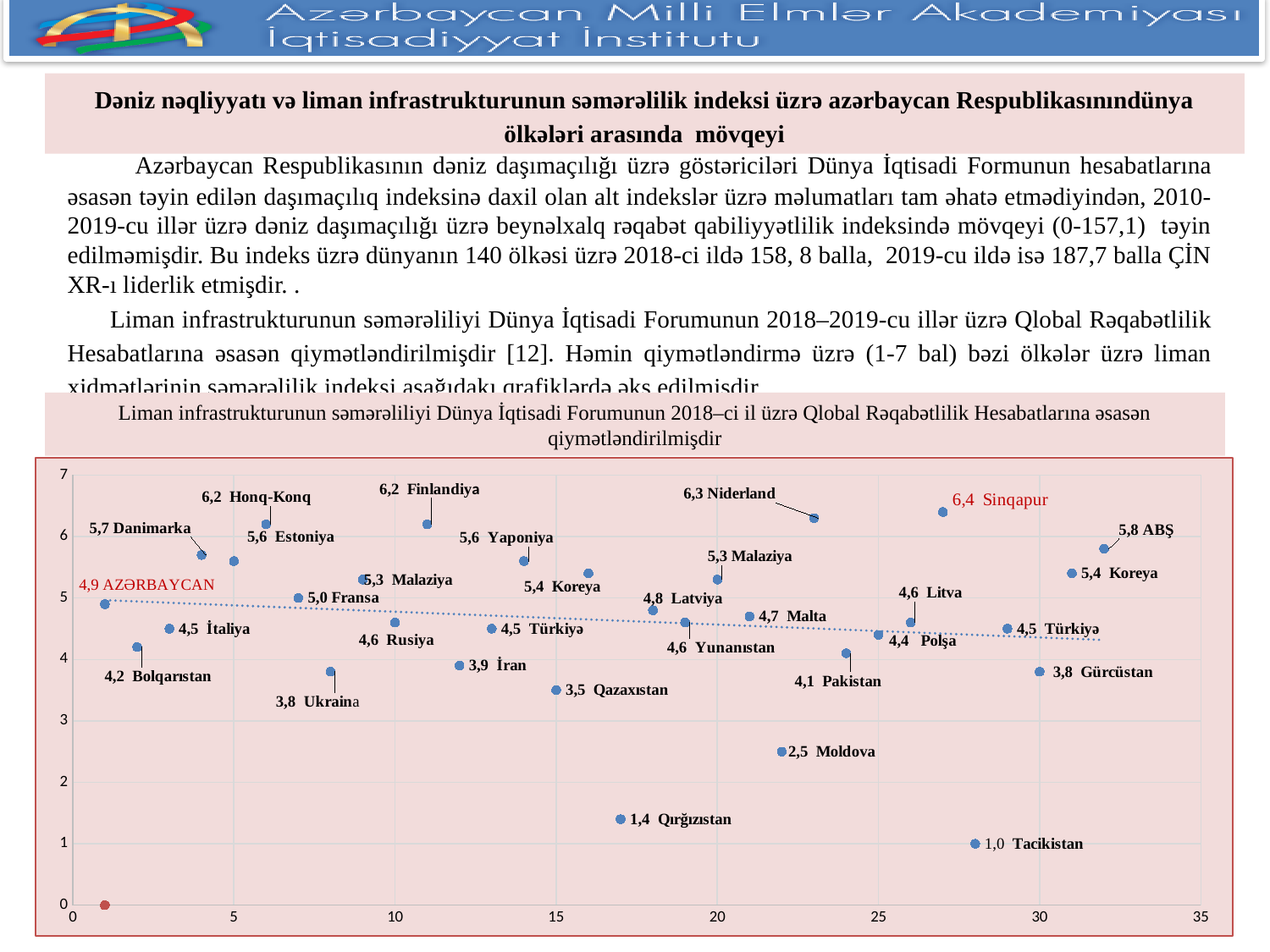
What is the value shown for Moldova in the chart? 2,5 What is the difference between the values for Qırğızıstan and Tacikistan? 0,4 Which country has the highest value in the chart? Sinqapur Which country has the lowest value in the chart? Tacikistan What is the value shown for AZƏRBAYCAN in the chart? 4,9 What is the maximum value shown on the vertical axis of the chart? 7 What is the value shown for Sinqapur in the chart? 6,4 What kind of chart is shown on the slide? scatter chart What is the value shown for Niderland in the chart? 6,3 What is the value shown for Tacikistan in the chart? 1,0 What is the difference between the values for Sinqapur and AZƏRBAYCAN? 1,5 Which has a higher value, Danimarka or Estoniya? Danimarka